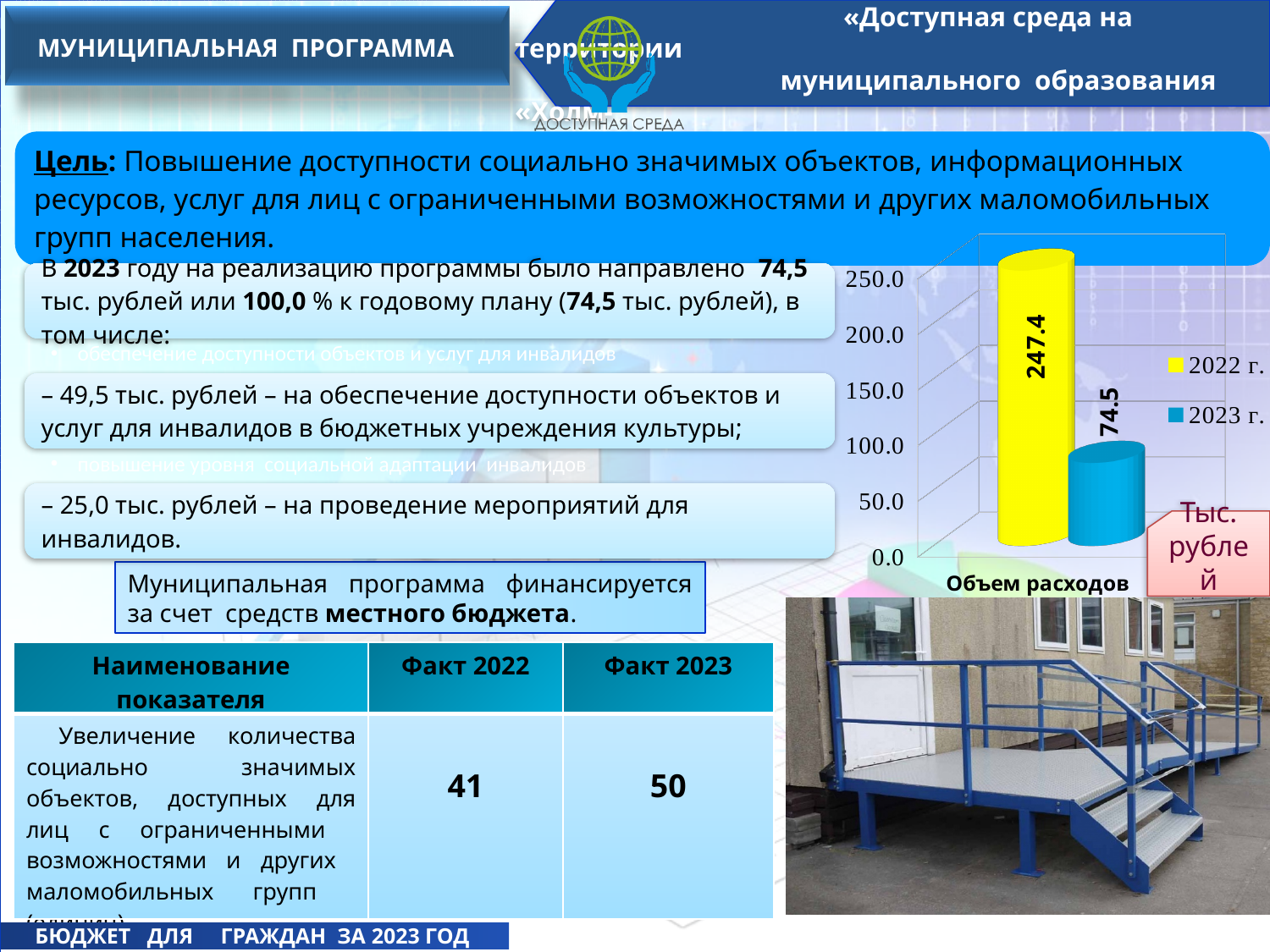
What is the value for 2023 г. in the chart? 74.5 What is the difference between the 2022 г. and 2023 г. values in the chart? 172.9 Is the value for 2022 г. greater or less than 200.0? greater What is the value for 2022 г. in the chart? 247.4 Which year has the higher value in the chart, 2022 г. or 2023 г.? 2022 г. Which series has the highest value in the chart? 2022 г. How many series does the chart legend list? 2 Is the value for 2023 г. greater or less than 100.0? less What is the category label shown under the bars in the chart? Объем расходов What colour is the bar for 2022 г. in the chart? yellow Which series has the lowest value in the chart? 2023 г. What kind of chart is shown on the slide? bar chart